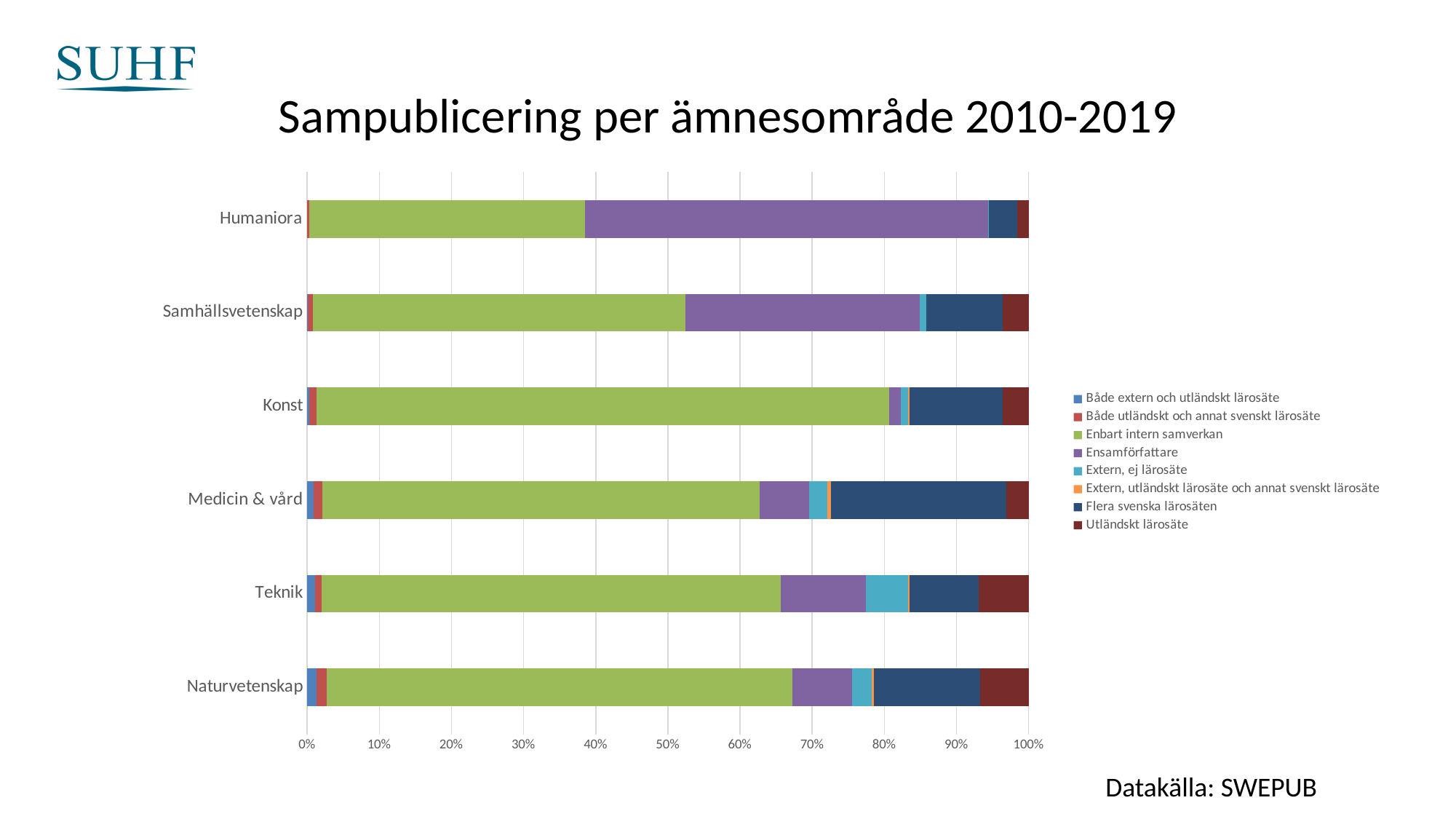
Which subject area has the largest Enbart intern samverkan share? Konst What kind of chart is shown on the slide? Stacked bar chart How many subject areas (categories) are shown on the chart? 6 Is the Enbart intern samverkan share for Humaniora greater or less than 40%? less Is the Enbart intern samverkan share for Samhällsvetenskap greater or less than 50%? greater What does each stacked bar total on the x axis? 100% Is the Enbart intern samverkan share for Naturvetenskap greater or less than 60%? greater What is the title of the chart? Sampublicering per ämnesområde 2010-2019 Which subject area has the largest Ensamförfattare share? Humaniora Which subject area has the largest Flera svenska lärosäten share? Medicin & vård How many series does the legend list? 8 Which has the larger Ensamförfattare share, Humaniora or Konst? Humaniora